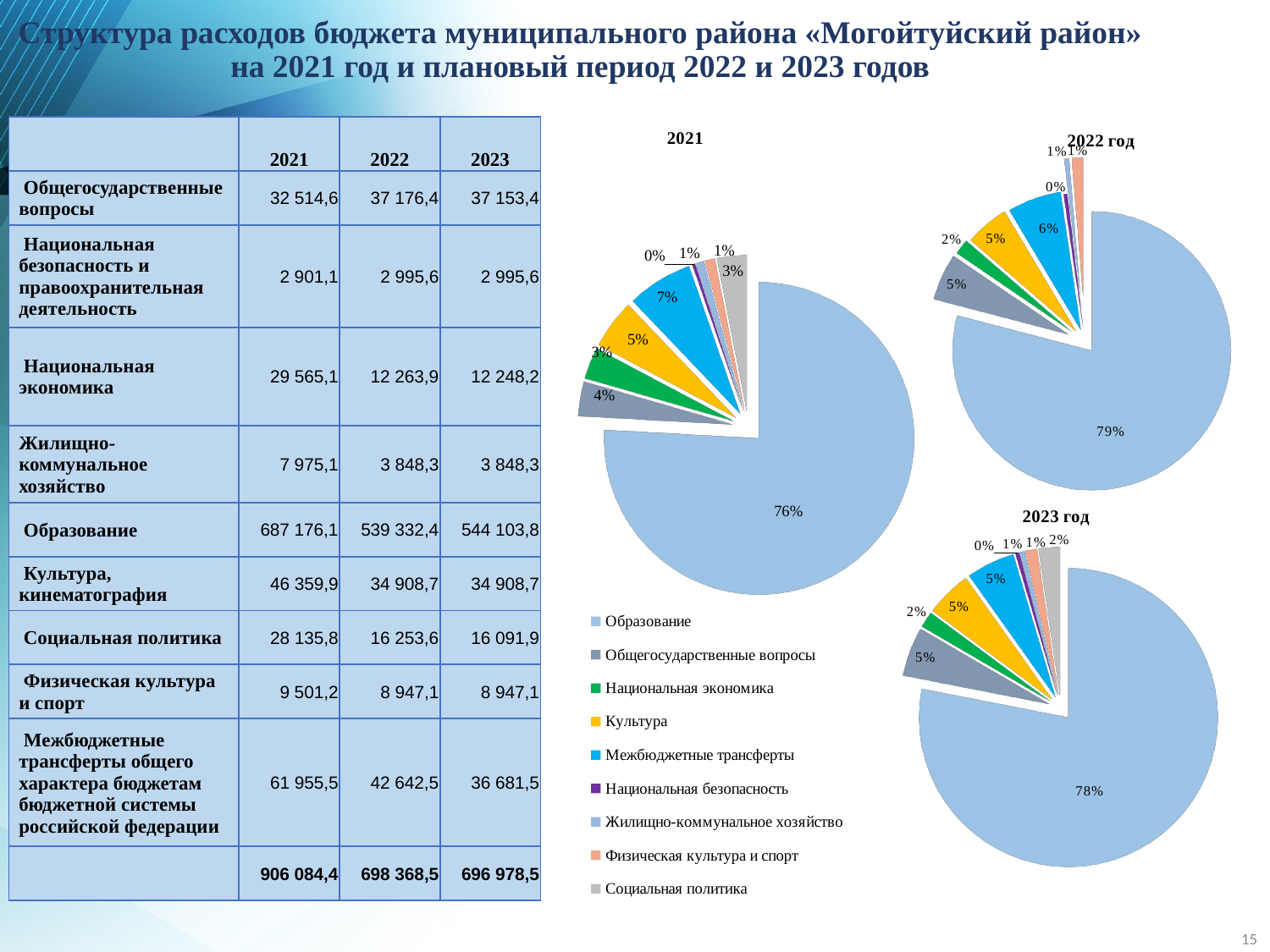
Which legend entry is shown in green? Национальная экономика In the 2021 chart, what share does Межбюджетные трансферты have? 7% What kind of chart is used for the 2021 chart? pie chart In the 2022 год chart, what share does Образование have? 79% In the 2023 год chart, what share does Образование have? 78% In the 2021 chart, which is larger: the slice for Культура or the slice for Национальная экономика? Культура How many pie charts are on the slide? 3 In the 2022 год chart, what share does Межбюджетные трансферты have? 6% In the 2021 chart, which category has the largest slice? Образование In the 2021 chart, what share does Образование have? 76% In the 2021 chart, what is the difference between the share of Образование and the share of Межбюджетные трансферты? 69% How many categories does the shared legend list? 9